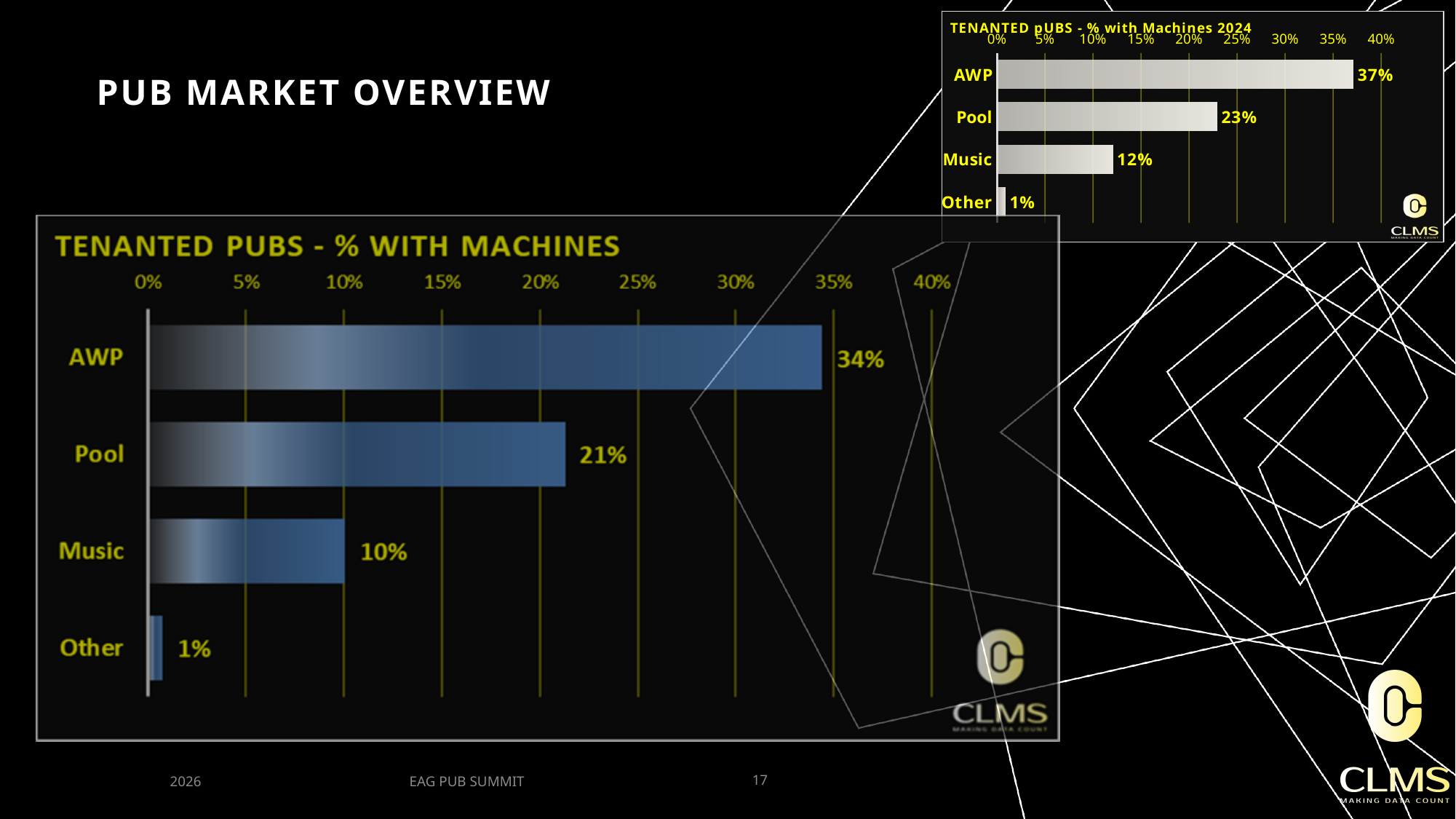
What kind of chart is the 'TENANTED PUBS - % WITH MACHINES' chart (large, lower left)? Bar chart In the 'TENANTED pUBS - % with Machines 2024' chart (top right), what is the difference between the AWP and Pool values? 14% In the 'TENANTED PUBS - % WITH MACHINES' chart (large, lower left), what is the value for Pool? 21% In the 'TENANTED pUBS - % with Machines 2024' chart (top right), what is the value for Music? 12% In the 'TENANTED pUBS - % with Machines 2024' chart (top right), what is the value for AWP? 37% In the 'TENANTED PUBS - % WITH MACHINES' chart (large, lower left), what is the difference between the Pool and Music values? 11% In the 'TENANTED PUBS - % WITH MACHINES' chart (large, lower left), what is the value for AWP? 34% How many categories are shown in the 'TENANTED pUBS - % with Machines 2024' chart (top right)? 4 In the 'TENANTED PUBS - % WITH MACHINES' chart (large, lower left), which category has the highest value? AWP In the 'TENANTED PUBS - % WITH MACHINES' chart (large, lower left), which is larger, the value for Music or the value for Other? Music In the 'TENANTED pUBS - % with Machines 2024' chart (top right), which category has the lowest value? Other In the 'TENANTED pUBS - % with Machines 2024' chart (top right), is the value for Pool greater or less than 20%? greater